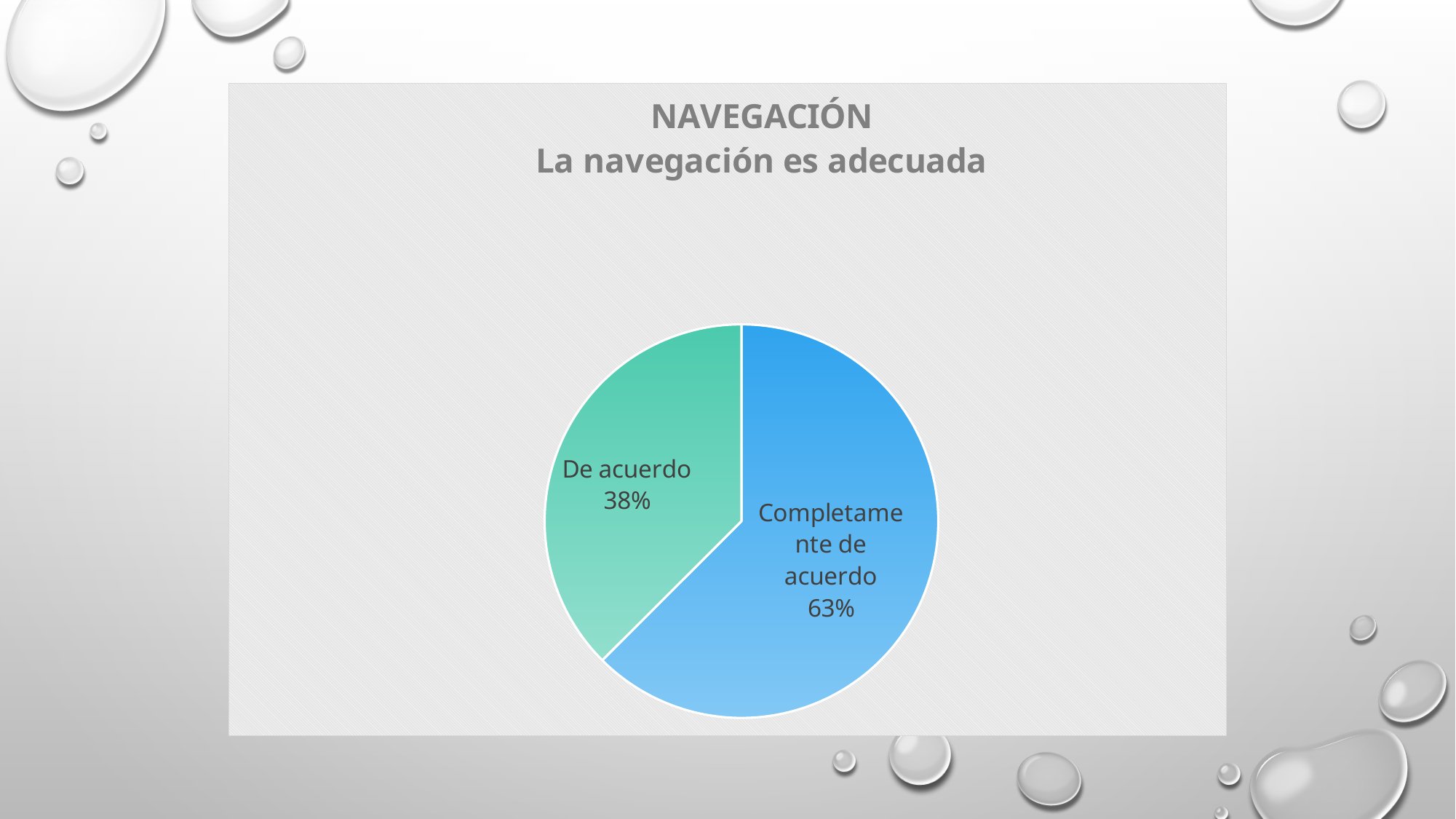
Which is larger, the slice for "De acuerdo" or the slice for "Completamente de acuerdo"? Completamente de acuerdo How many categories are shown in the pie chart? 2 What share of the pie does "Completamente de acuerdo" represent? 63% What kind of chart is shown on the slide? Pie chart What is the title of the chart? NAVEGACIÓN La navegación es adecuada What colour is the slice for "De acuerdo"? Green What share of the pie does "De acuerdo" represent? 38% Which category has the smallest slice of the pie? De acuerdo Which category has the largest slice of the pie? Completamente de acuerdo What is the difference in percentage points between "Completamente de acuerdo" and "De acuerdo"? 25 percentage points